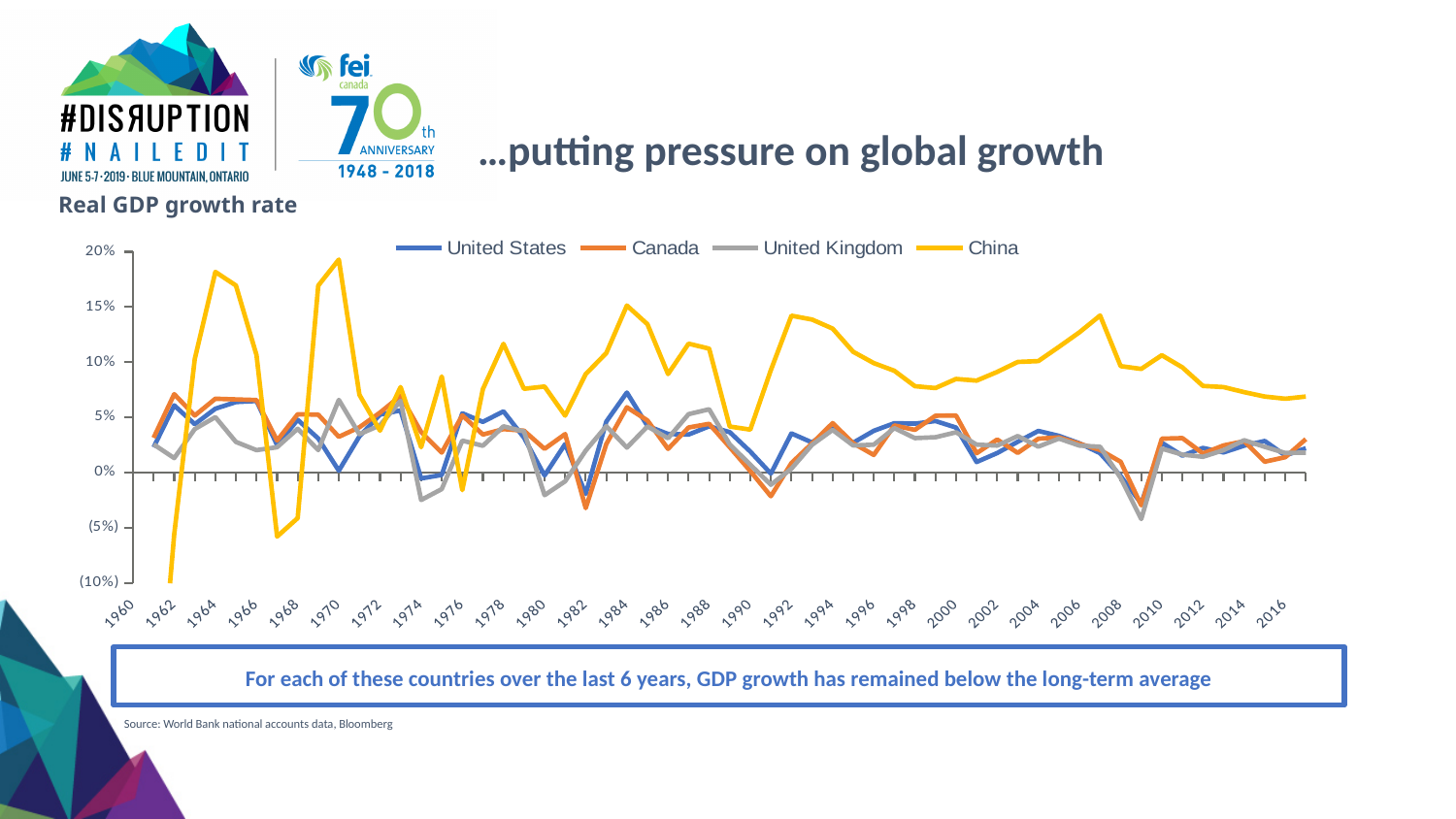
Which countries are listed in the chart legend? United States, Canada, United Kingdom, China In 1970, which is larger: the value for China or the value for the United States? China How many series does the legend list? 4 What colour is the line for China? Yellow Is the value for the United Kingdom in 2009 greater or less than 0%? less Is the value for China in 1970 greater or less than 15%? greater In 1962, which is larger: the value for the United States or the value for China? United States What type of chart is shown on the slide? Line chart Does the value for China rise or fall from 2010 to 2016? Fall Is the value for China in 2007 greater or less than 10%? greater Which series reaches the highest value anywhere on the chart? China